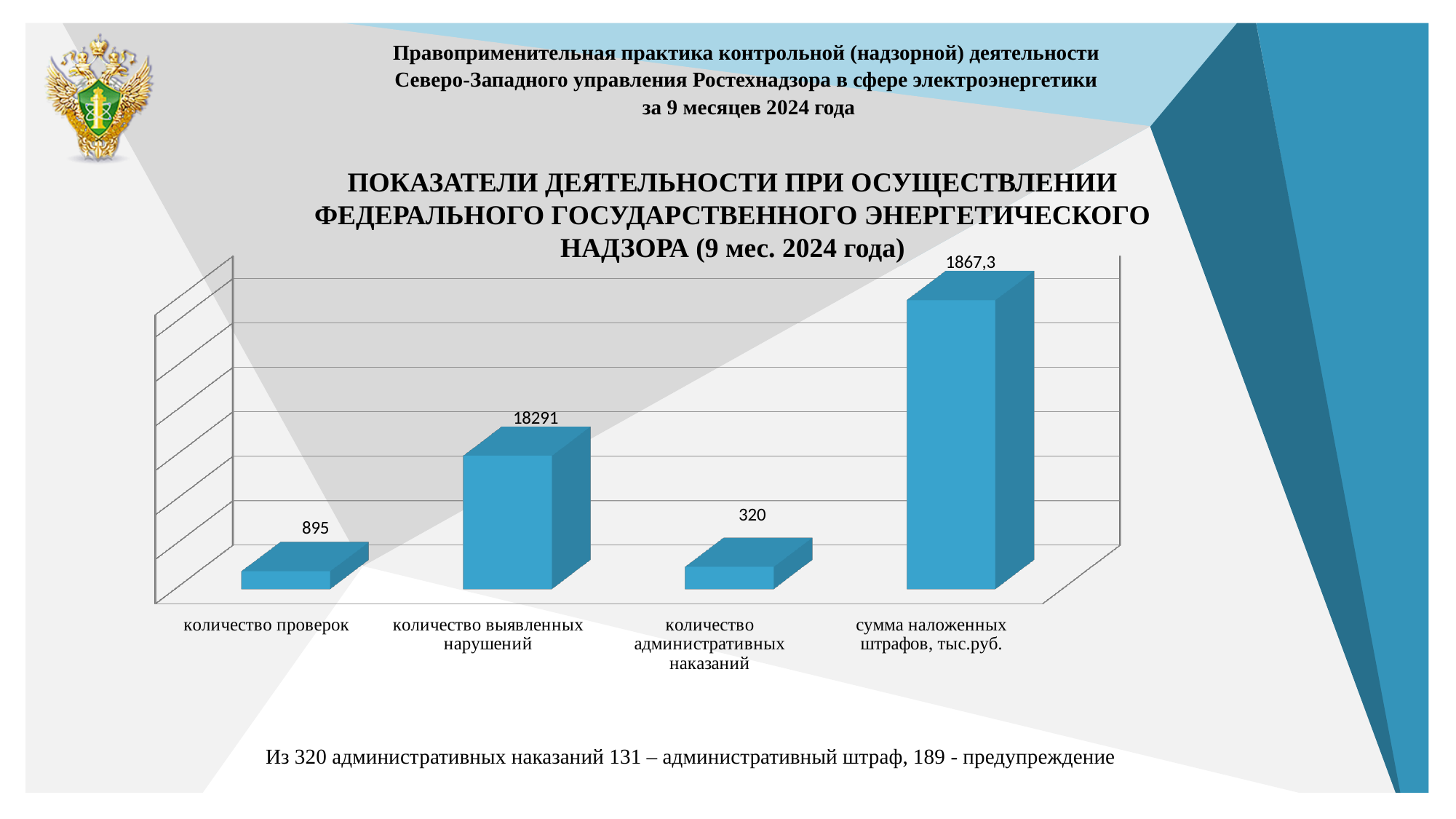
What period does the chart title refer to? 9 мес. 2024 года What is the difference between the values for «количество выявленных нарушений» and «количество проверок»? 17396 Which category has the lowest value in the chart? количество административных наказаний What is the value shown for «количество проверок»? 895 Which is larger: the value for «количество проверок» or for «количество административных наказаний»? количество проверок What kind of chart is shown on the slide? bar chart What colour are the bars in the chart? blue What is the value shown for «количество административных наказаний»? 320 What is the difference between the values for «количество проверок» and «количество административных наказаний»? 575 How many categories are shown in the chart? 4 What is the value shown for «количество выявленных нарушений»? 18291 What is the value shown for «сумма наложенных штрафов, тыс.руб.»? 1867,3